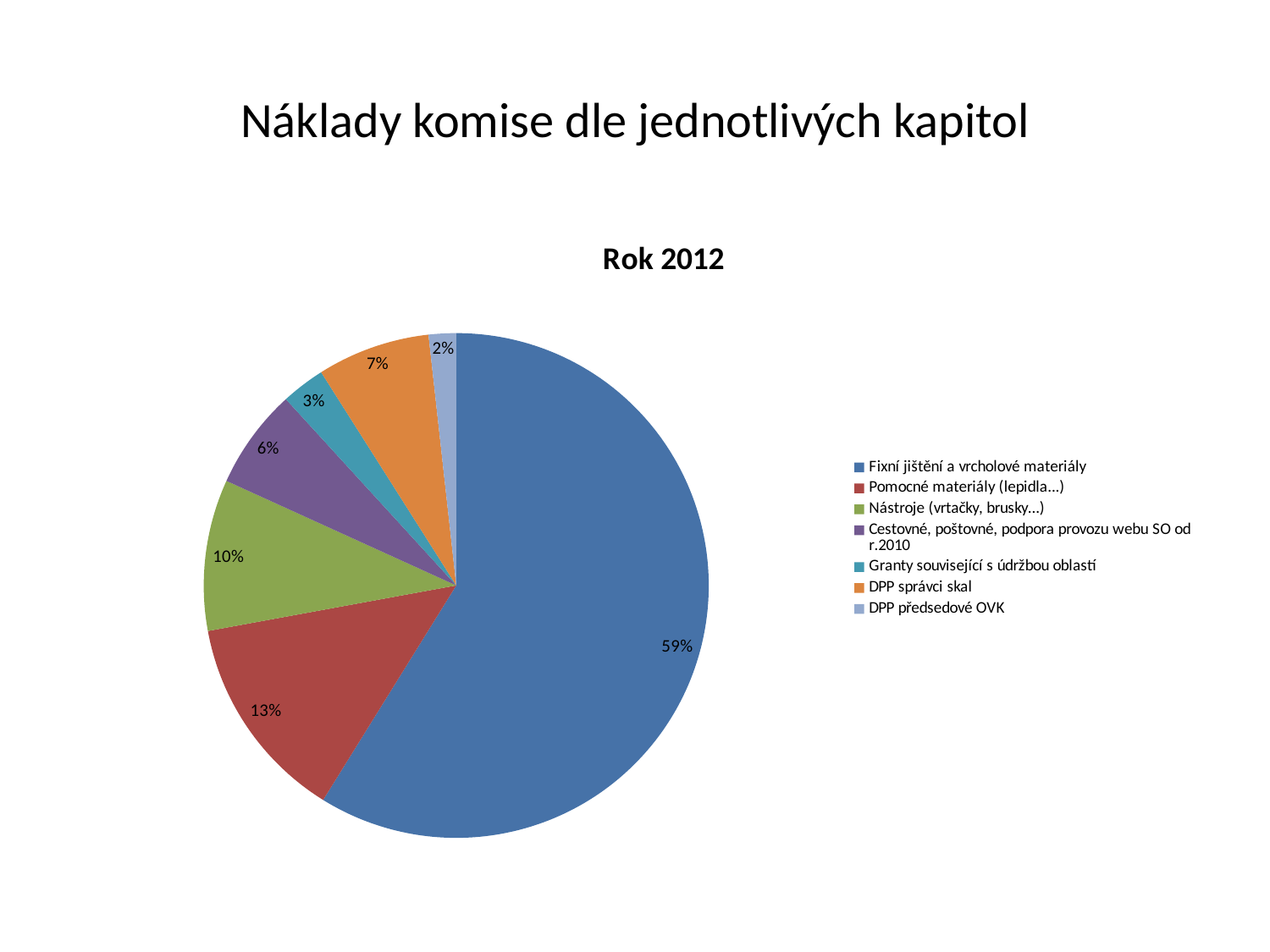
How many categories does the pie chart have? 7 Which is larger: the share for 'DPP správci skal' or the share for 'Cestovné, poštovné, podpora provozu webu SO od r.2010'? DPP správci skal Which category has the smallest slice of the pie? DPP předsedové OVK What is the difference in percentage points between 'Fixní jištění a vrcholové materiály' and 'Pomocné materiály (lepidla...)'? 46 What share of the pie does 'Nástroje (vrtačky, brusky...)' have? 10% What share of the pie does 'Granty související s údržbou oblastí' have? 3% What is the chart's title? Rok 2012 What share of the pie does 'Fixní jištění a vrcholové materiály' have? 59% What kind of chart is shown on the slide? pie chart Which category has the largest slice of the pie? Fixní jištění a vrcholové materiály